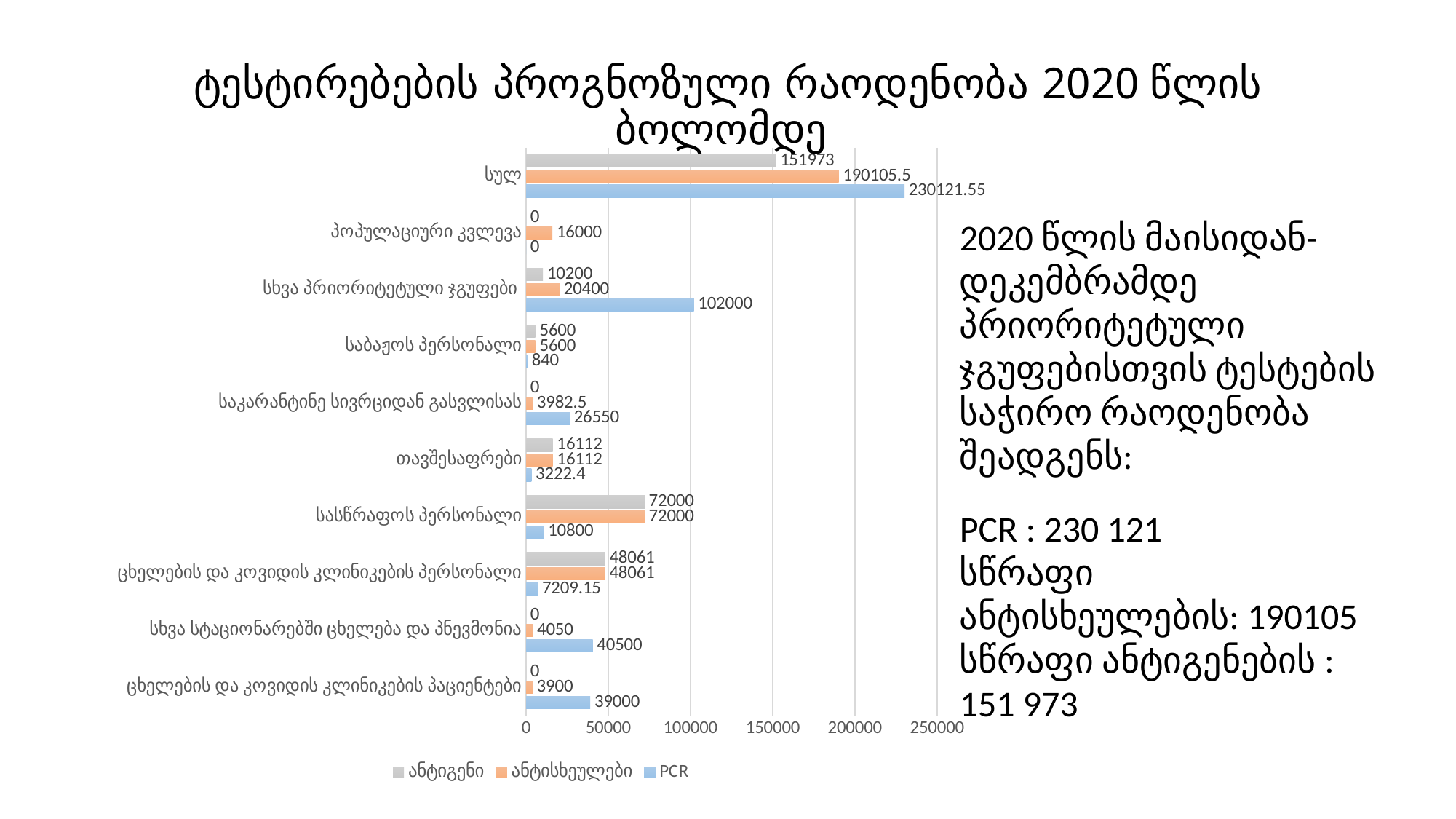
For თავშესაფრები, which is larger: the ანტიგენი value or the PCR value? ანტიგენი Is the ანტისხეულები value for სულ greater or less than 200000? less How many series does the legend list? 3 What type of chart is shown on the slide? bar chart What is the PCR value for საკარანტინე სივრციდან გასვლისას? 26550 Which category has the lowest PCR value? პოპულაციური კვლევა What is the PCR value for სულ? 230121.55 Excluding სულ, which category has the highest PCR value? სხვა პრიორიტეტული ჯგუფები What is the ანტისხეულები value for სხვა პრიორიტეტული ჯგუფები? 20400 What is the difference between the PCR value and the ანტისხეულები value for სხვა სტაციონარებში ცხელება და პნევმონია? 36450 How many categories are shown on the chart? 10 What is the ანტიგენი value for სასწრაფოს პერსონალი? 72000